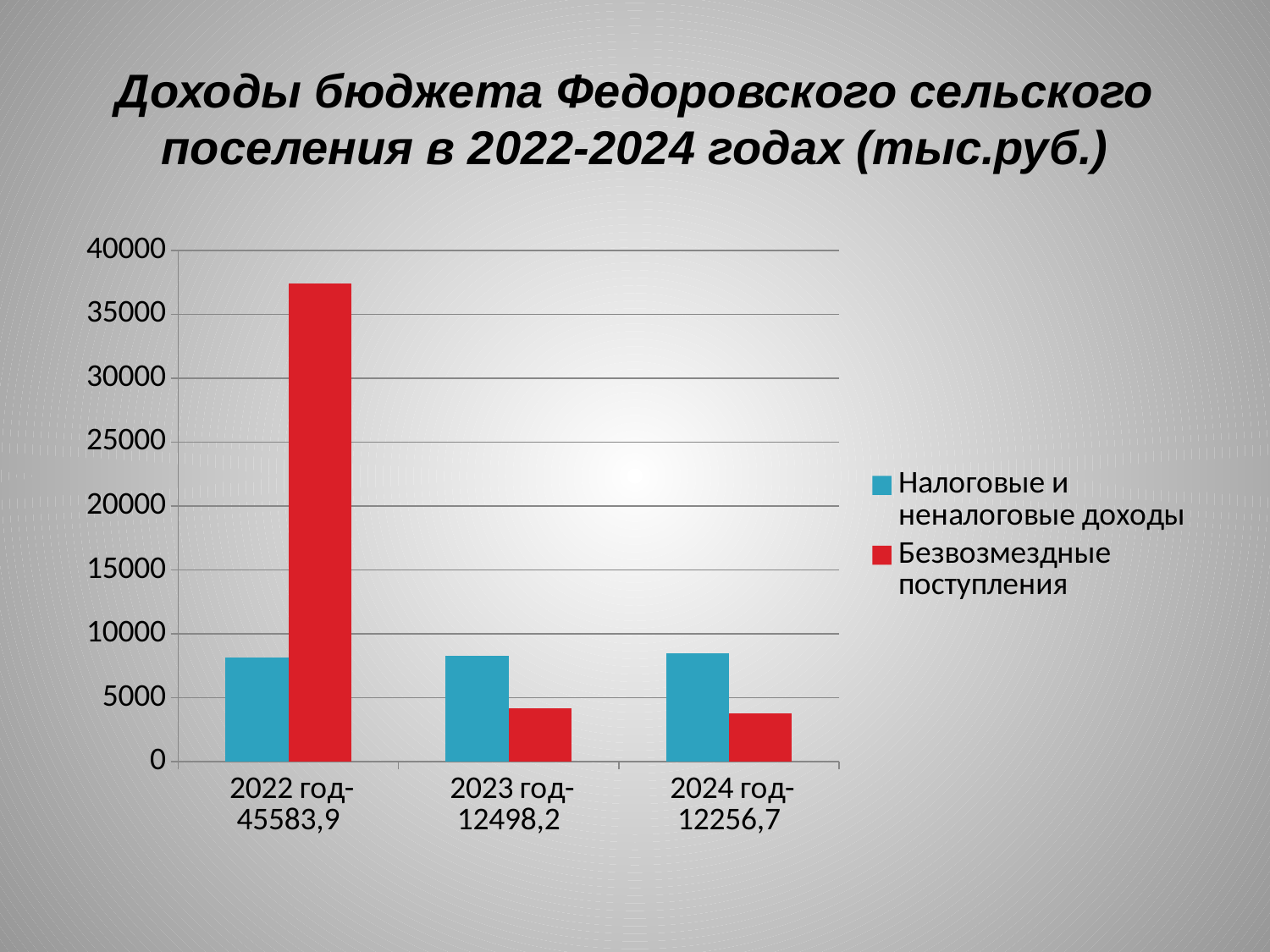
What kind of chart is shown on the slide? bar chart Is the value for Безвозмездные поступления in 2022 greater or less than 35000? greater What total is printed in the x-axis label for 2022? 45583,9 Is the value for Налоговые и неналоговые доходы in 2022 greater or less than 10000? less In 2023, which is larger: Налоговые и неналоговые доходы or Безвозмездные поступления? Налоговые и неналоговые доходы Do the values for Безвозмездные поступления rise or fall from 2022 to 2024? fall In 2022, which is larger: Налоговые и неналоговые доходы or Безвозмездные поступления? Безвозмездные поступления How many year categories are shown on the x axis? 3 How many series does the legend list? 2 Which year has the highest bar for Безвозмездные поступления? 2022 год Is the value for Безвозмездные поступления in 2024 greater or less than 5000? less Which colour represents Безвозмездные поступления in the legend? red